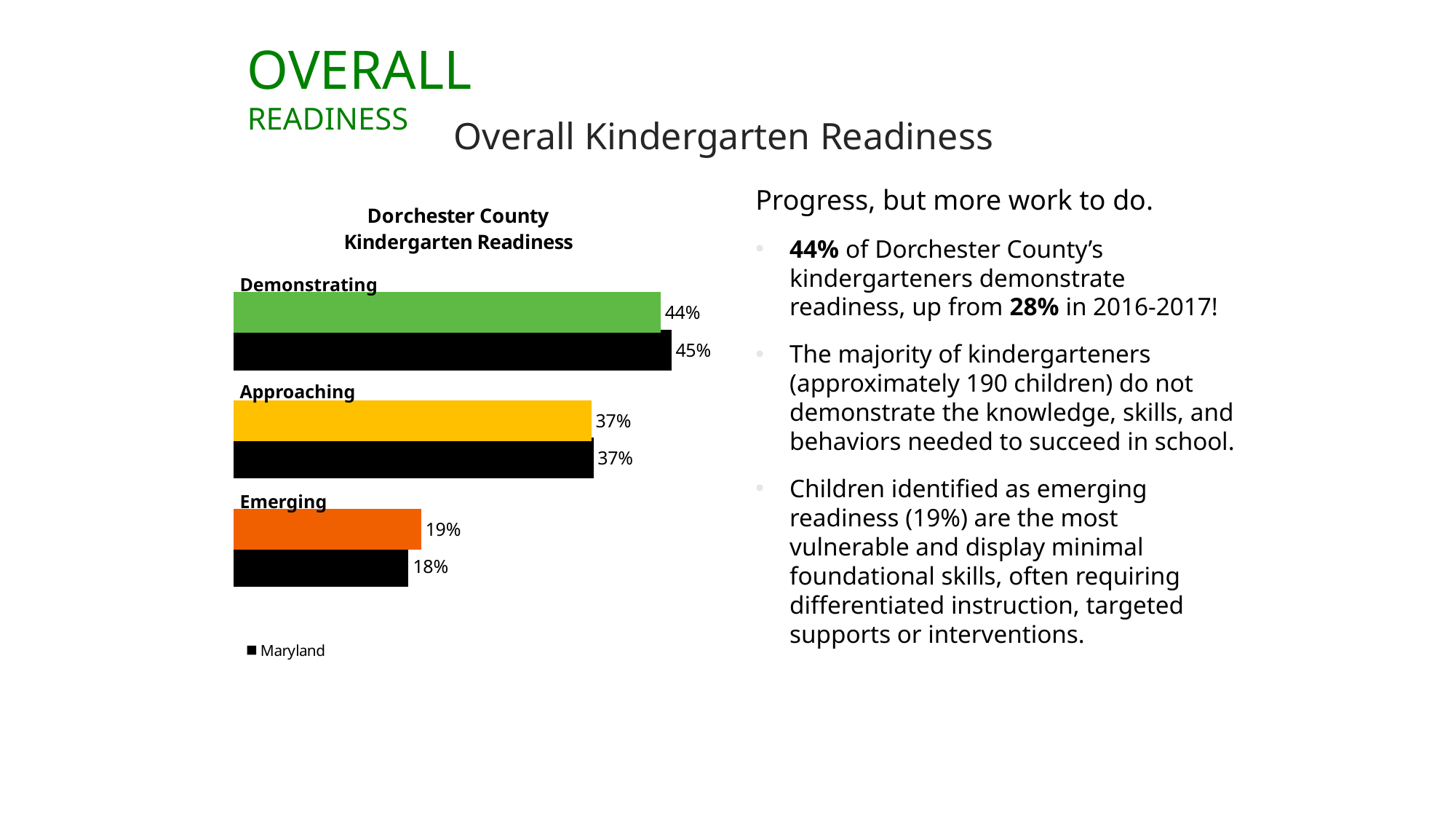
What is the value of the orange bar for Emerging? 19% Which category has the lowest Maryland value? Emerging How many series does the chart's legend list? 1 What is the Maryland value for Emerging? 18% What is the value of the green bar for Demonstrating? 44% What is the Maryland value for Demonstrating? 45% What is the title of the chart? Dorchester County Kindergarten Readiness What type of chart is shown on the slide? bar chart What is the difference between the Maryland values for Demonstrating and Emerging? 27% How many categories are shown in the chart? 3 Which category has the highest Maryland value? Demonstrating What is the value of the yellow bar for Approaching? 37%